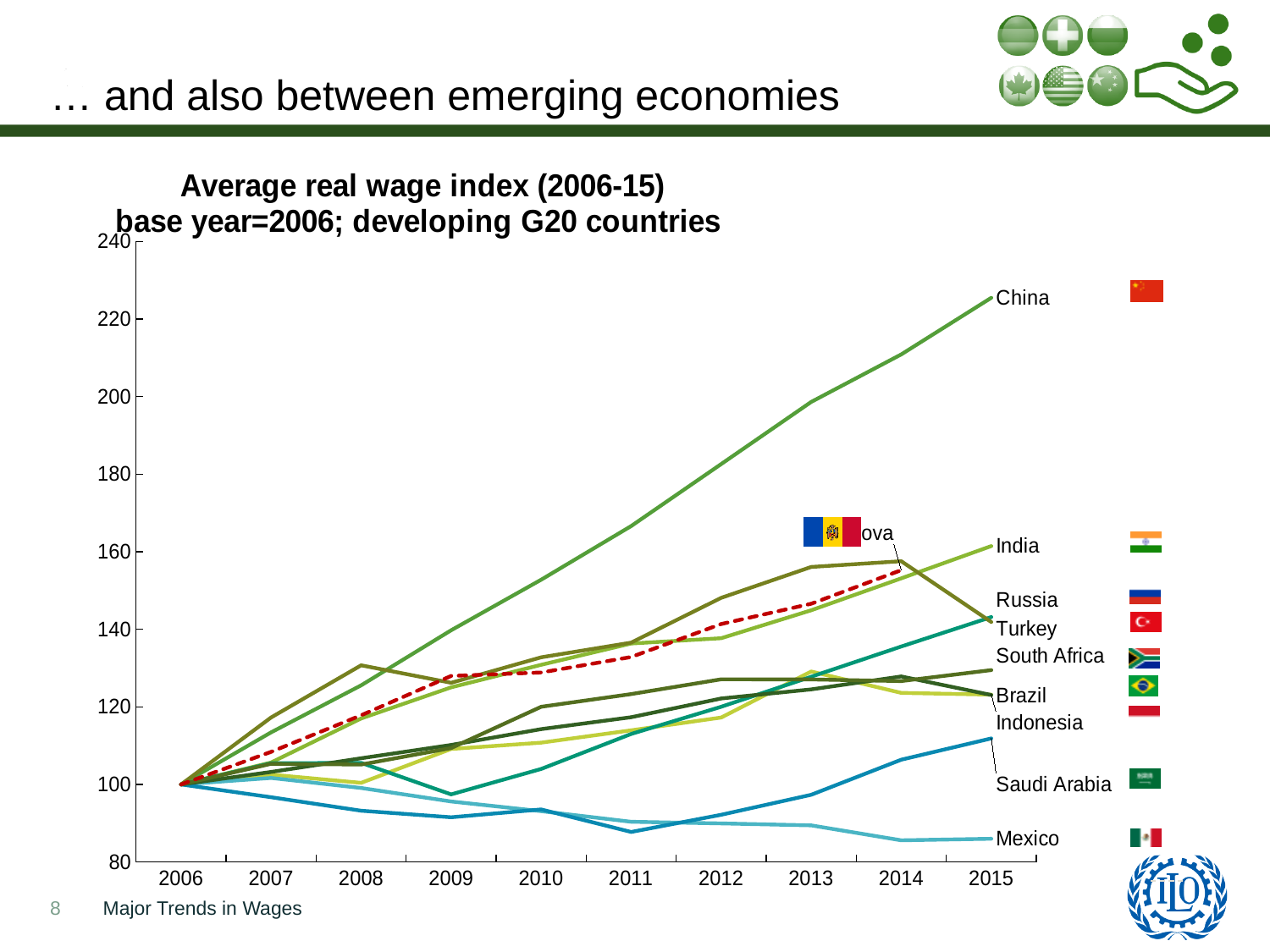
Is the value for China in 2015 greater or less than 220? greater Is the value for Mexico in 2015 greater or less than 100? less What kind of chart is shown on the slide? line chart Is the value for India in 2015 greater or less than 140? greater Which is larger in 2015, the value for Saudi Arabia or the value for Mexico? Saudi Arabia What is the title of the chart? Average real wage index (2006-15) base year=2006; developing G20 countries Which country has the highest real wage index in 2015? China Which is larger in 2015, the value for China or the value for India? China Does the line for China rise or fall from 2006 to 2015? rise What is the real wage index value for China in 2006? 100 How many years are shown on the x axis of the chart? 10 Which country has the lowest real wage index in 2015? Mexico